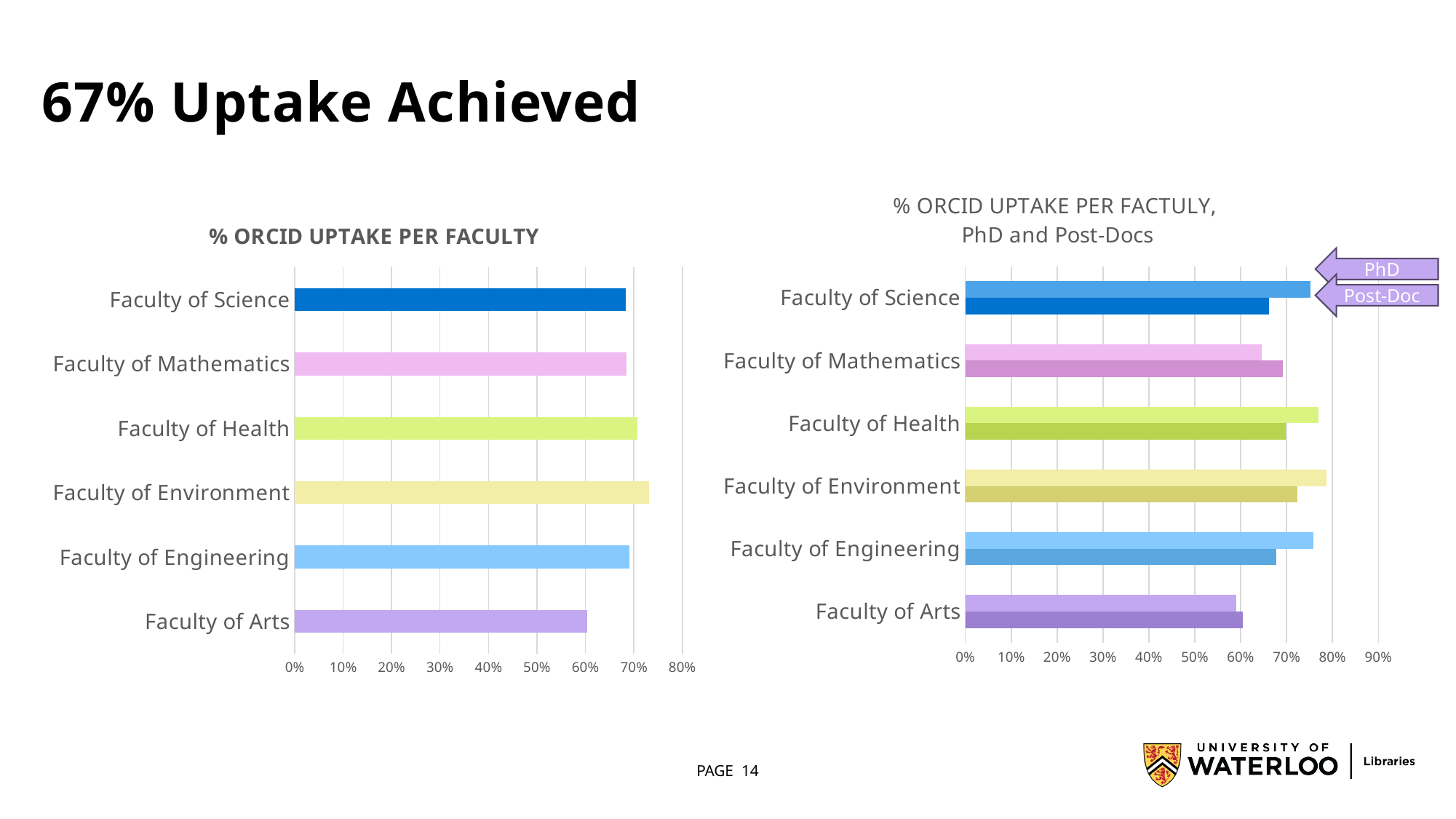
In the right chart (PhD and Post-Docs), is the PhD value for Faculty of Environment greater or less than 70%? greater In the right chart (PhD and Post-Docs), is the PhD value for Faculty of Arts greater or less than 70%? less What is the highest value shown on the x axis of the right chart (PhD and Post-Docs)? 90% In the left chart (% ORCID UPTAKE PER FACULTY), is the value for Faculty of Environment greater or less than 70%? greater What kind of chart is the left chart titled "% ORCID UPTAKE PER FACULTY"? bar chart How many faculties are shown in the left chart (% ORCID UPTAKE PER FACULTY)? 6 In the left chart (% ORCID UPTAKE PER FACULTY), which faculty has the highest uptake? Faculty of Environment In the left chart (% ORCID UPTAKE PER FACULTY), which faculty has the lowest uptake? Faculty of Arts How many series does the right chart (% ORCID UPTAKE PER FACTULY, PhD and Post-Docs) show? 2